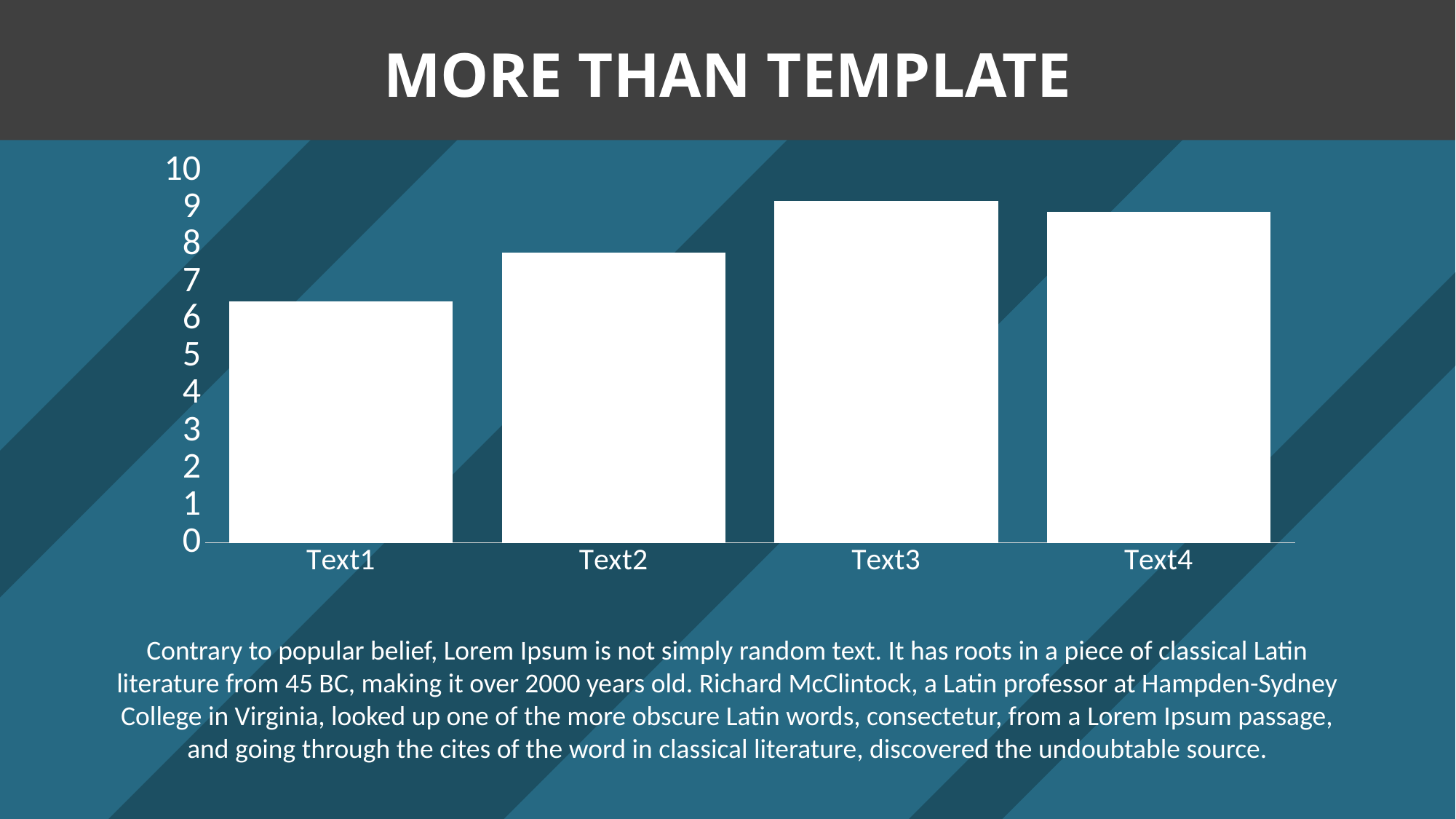
What is the title shown above the chart on the slide? MORE THAN TEMPLATE Is the value for Text1 greater or less than 8? less What kind of chart is shown on the slide? bar chart Is the value for Text2 greater or less than 7? greater How many categories are plotted on the x axis of the chart? 4 Which category has the lowest bar in the chart? Text1 Is the value for Text4 greater or less than 10? less Which is larger, the value for Text1 or the value for Text2? Text2 Which is larger, the value for Text1 or the value for Text4? Text4 Which is larger, the value for Text2 or the value for Text3? Text3